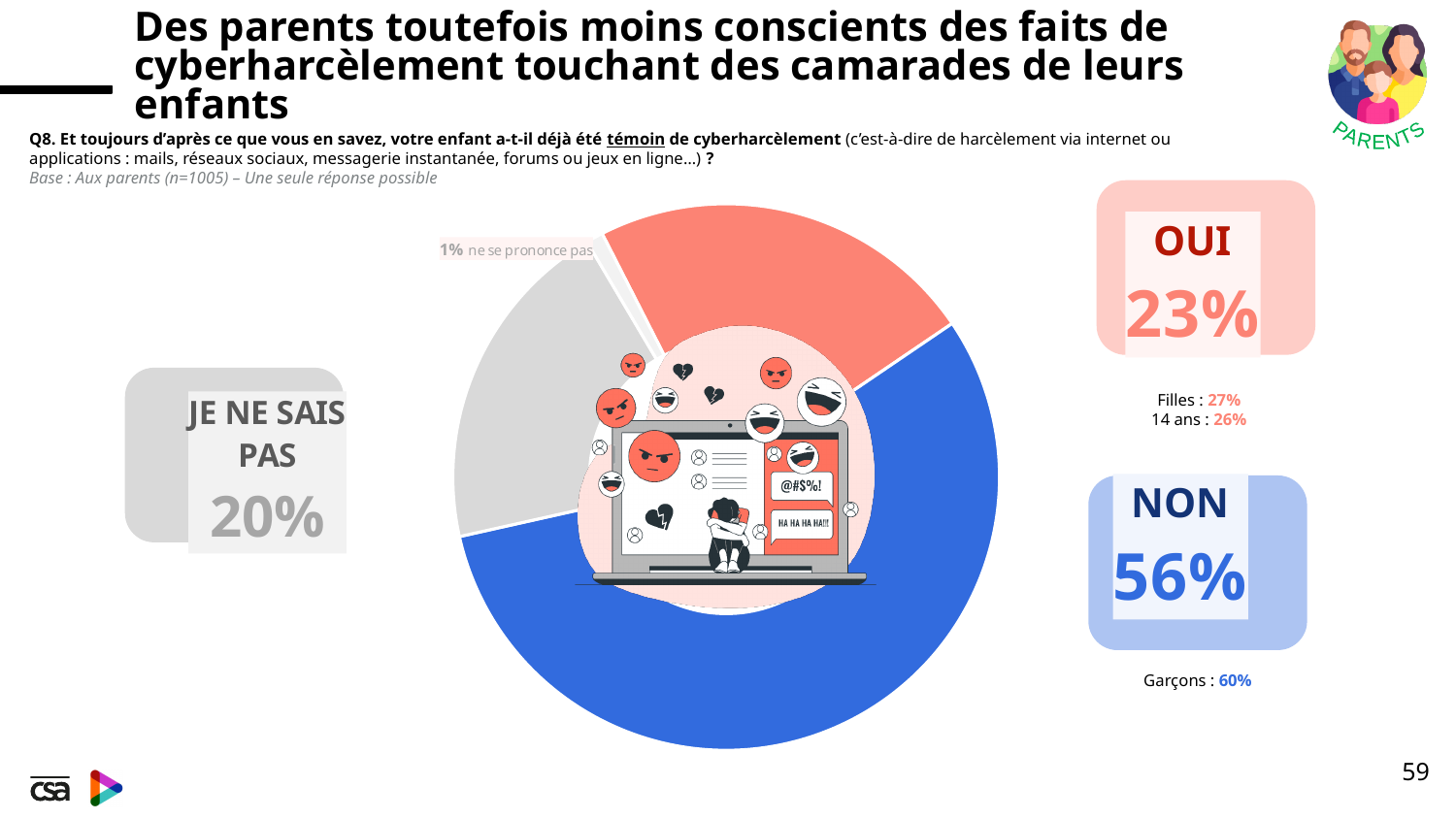
What is the difference in percentage points between "NON" and "OUI"? 33 What percentage of parents answered "JE NE SAIS PAS"? 20% Which is larger, the share for "OUI" or the share for "JE NE SAIS PAS"? OUI Which answer has the largest share of the pie? NON What percentage of parents answered "OUI"? 23% What percentage of parents answered "NON"? 56% What percentage of parents of girls (Filles) answered "OUI"? 27% What percentage of parents of boys (Garçons) answered "NON"? 60% What kind of chart is shown on the slide? Doughnut chart What share of parents "ne se prononce pas"? 1% Which answer has the smallest share of the pie? ne se prononce pas How many answer categories are shown in the pie chart? 4